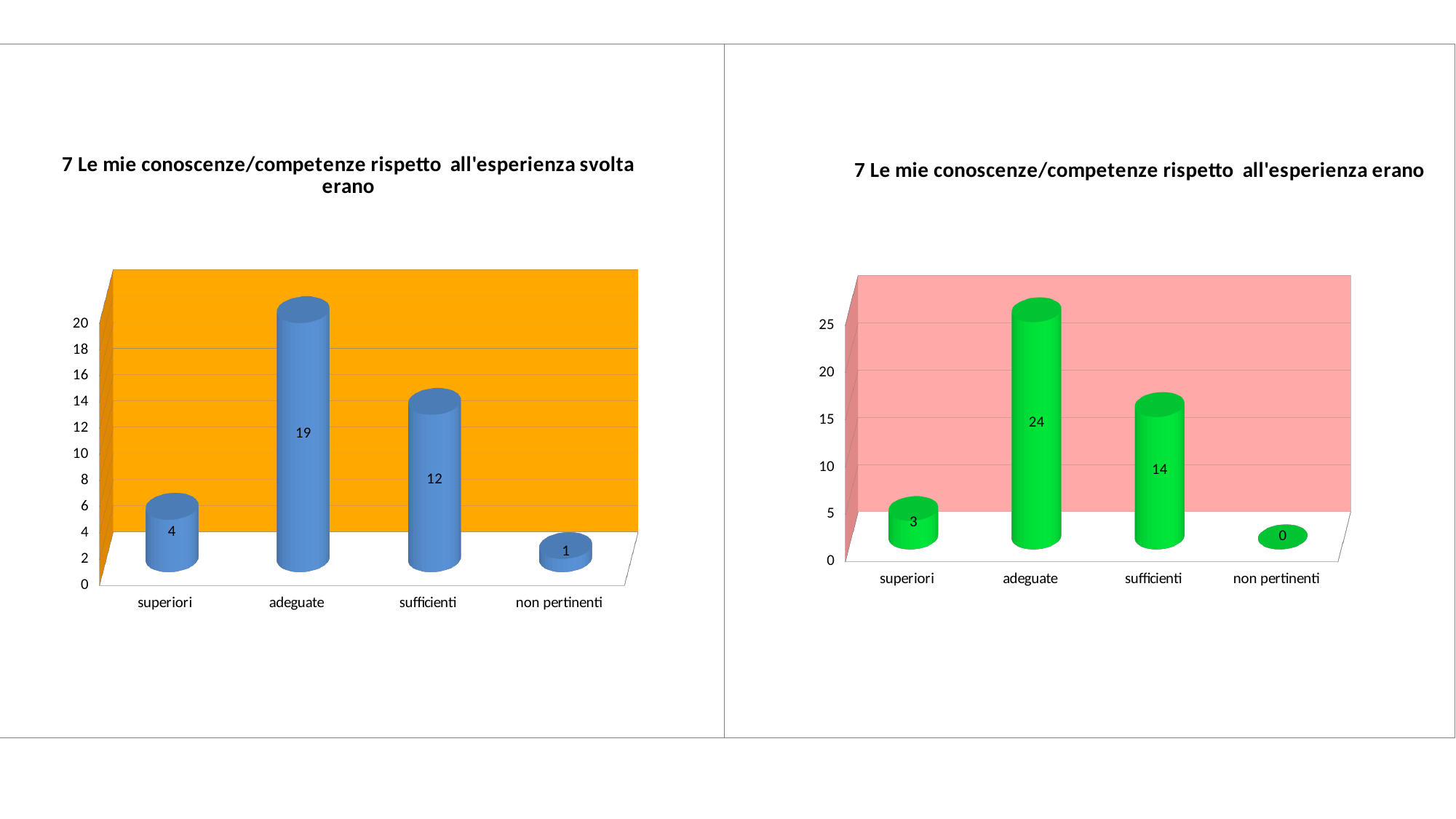
In the left chart, what is the value for non pertinenti? 1 What colour are the bars in the right chart? green In the right chart, what is the value for superiori? 3 In the right chart, what is the difference between the values for adeguate and superiori? 21 What kind of chart is the right chart? bar chart In the right chart, which is larger, the value for sufficienti or the value for superiori? sufficienti In the right chart, what is the value for sufficienti? 14 How many categories does the left chart show? 4 In the left chart, what is the difference between the values for adeguate and sufficienti? 7 In the left chart, what is the value for adeguate? 19 In the left chart, which category has the highest value? adeguate In the right chart, which category has the lowest value? non pertinenti